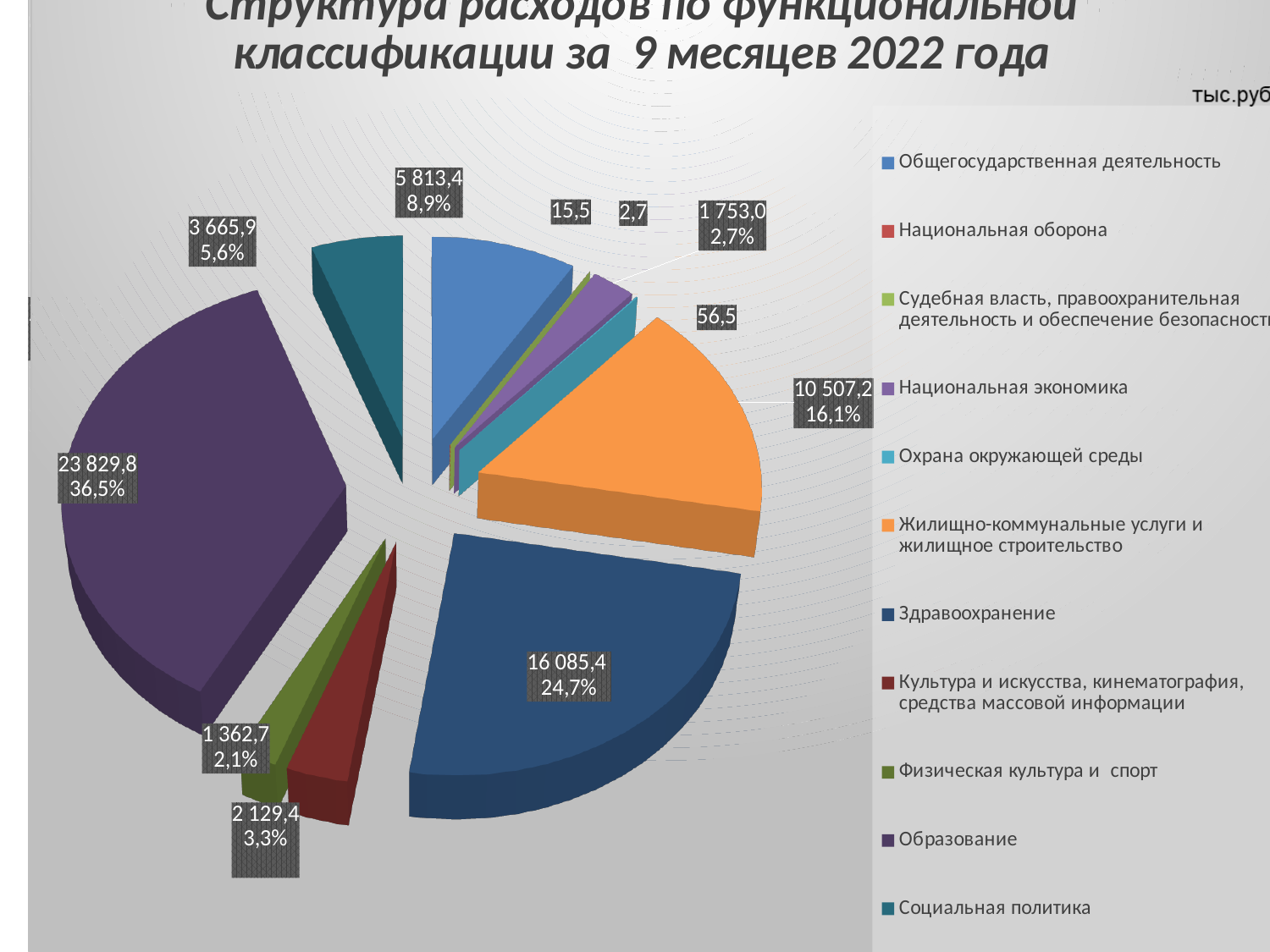
What is the difference between the values for Образование and Здравоохранение? 7 744,4 What share of the pie does Социальная политика account for? 5,6% What is the value for Физическая культура и спорт? 1 362,7 What share of the pie does Общегосударственная деятельность account for? 8,9% What unit of measurement is indicated on the slide for the chart values? тыс.руб Which category has the largest slice of the pie? Образование Which is larger: Здравоохранение or Жилищно-коммунальные услуги и жилищное строительство? Здравоохранение What share of the pie does Здравоохранение account for? 24,7% What is the value for Образование? 23 829,8 What is the value for Жилищно-коммунальные услуги и жилищное строительство? 10 507,2 What type of chart is shown on the slide? Pie chart How many categories does the legend list? 11